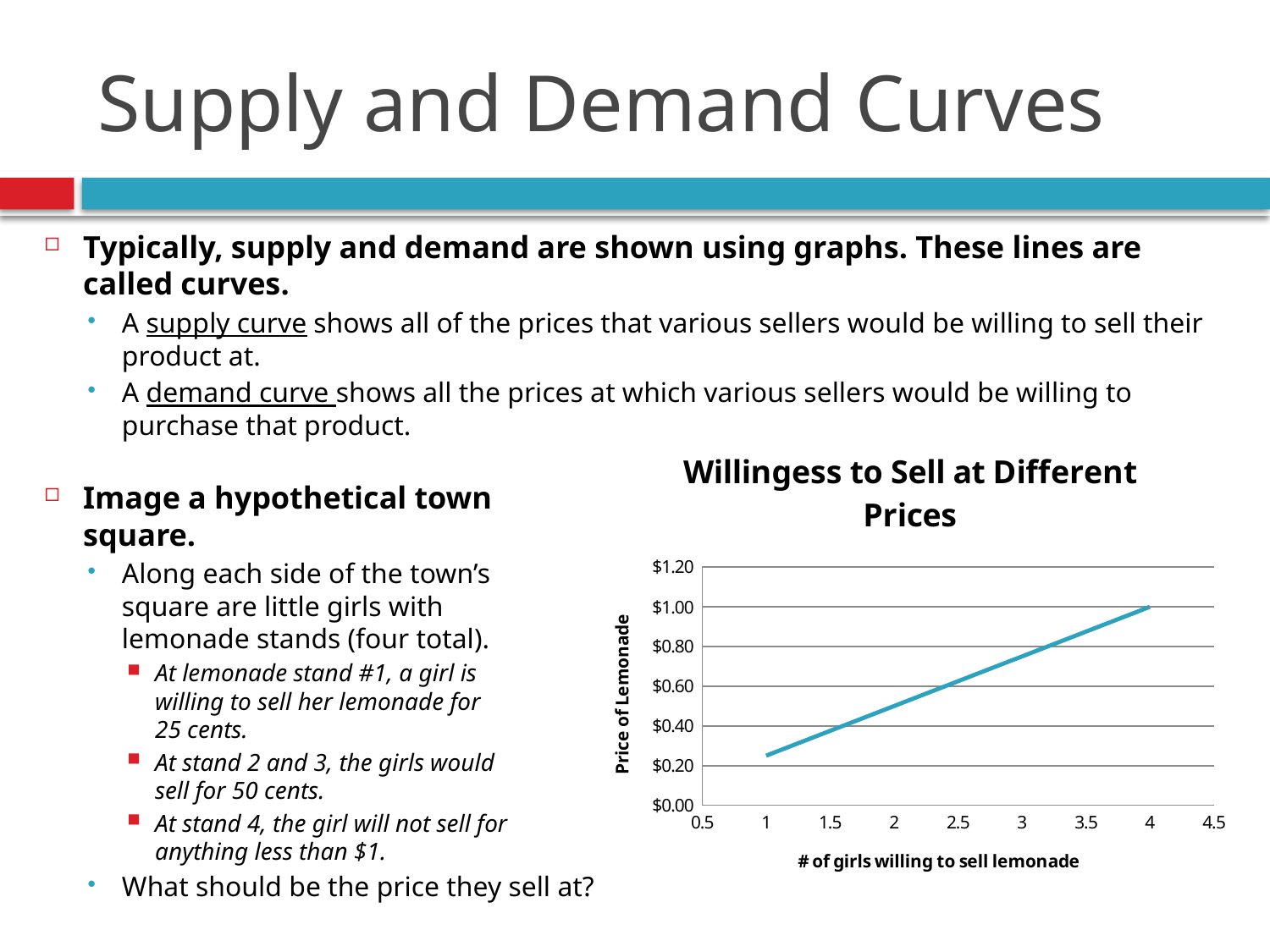
What is the label of the vertical axis of the chart? Price of Lemonade What is the title of the chart? Willingess to Sell at Different Prices Which end of the line has the higher price: the point at 1 girl or the point at 4 girls? 4 girls What is the highest value shown on the vertical axis of the chart? $1.20 Does the price of lemonade rise or fall as the number of girls willing to sell increases along the x axis? rise Is the price of lemonade when 2 girls are willing to sell greater or less than $0.60? less Is the price of lemonade when 1 girl is willing to sell greater or less than $0.40? less Is the price of lemonade when 2 girls are willing to sell greater or less than $0.40? greater What kind of chart is shown on the slide? line chart What is the price of lemonade when 4 girls are willing to sell? $1.00